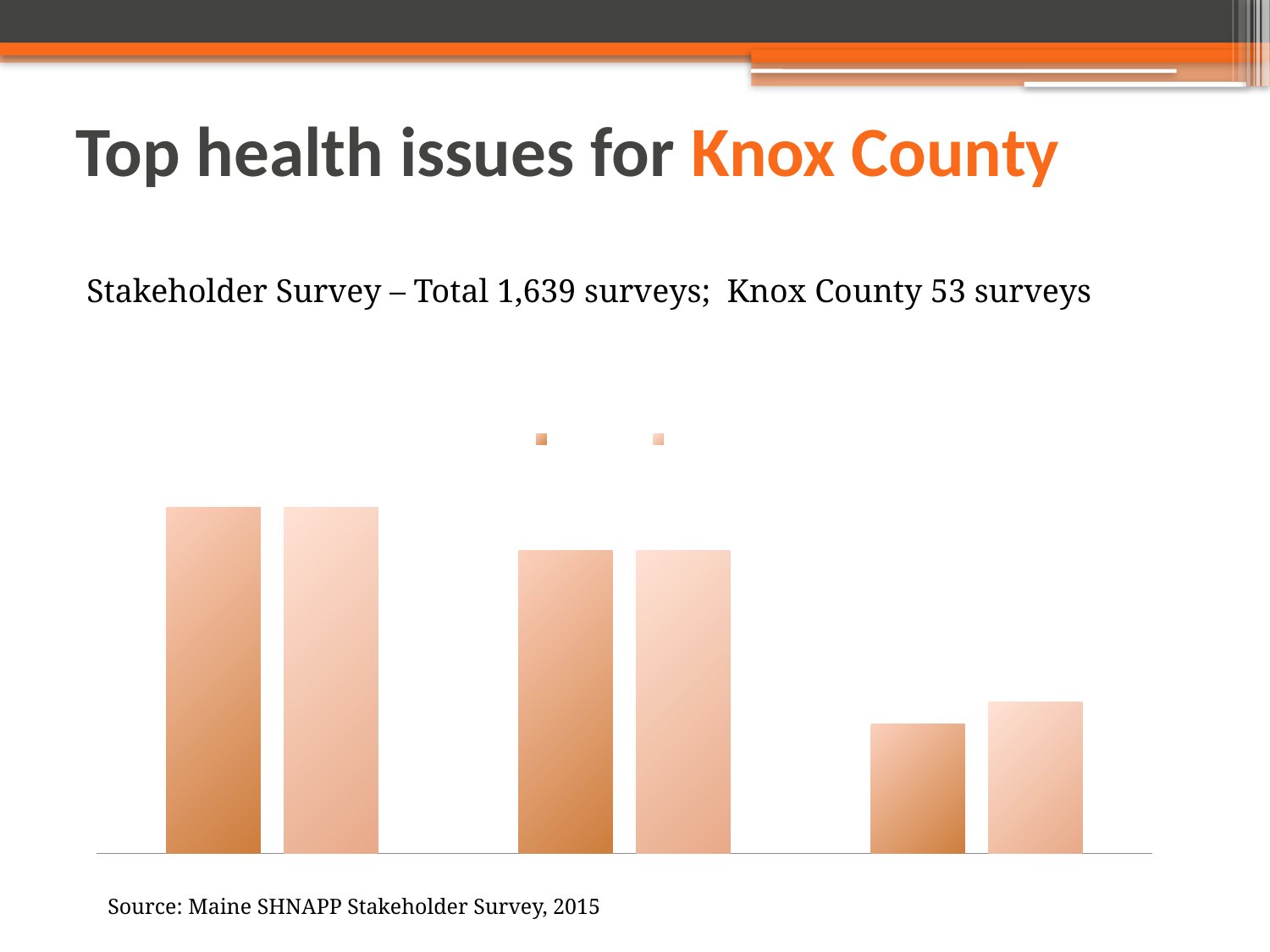
How many bars are in each group of the chart? 2 Does the chart display any data labels on its bars? No Which group of bars is the tallest: the leftmost, middle, or rightmost? leftmost How many groups of bars are plotted in the chart? 3 Which group of bars is the shortest: the leftmost, middle, or rightmost? rightmost Do the bar heights rise or fall from left to right across the groups? fall What source is cited below the chart? Maine SHNAPP Stakeholder Survey, 2015 How many bars in total are plotted in the chart? 6 What kind of chart is shown on the slide? bar chart In the rightmost group, is the darker bar or the lighter bar taller? the lighter bar How many series does the chart's legend list? 2